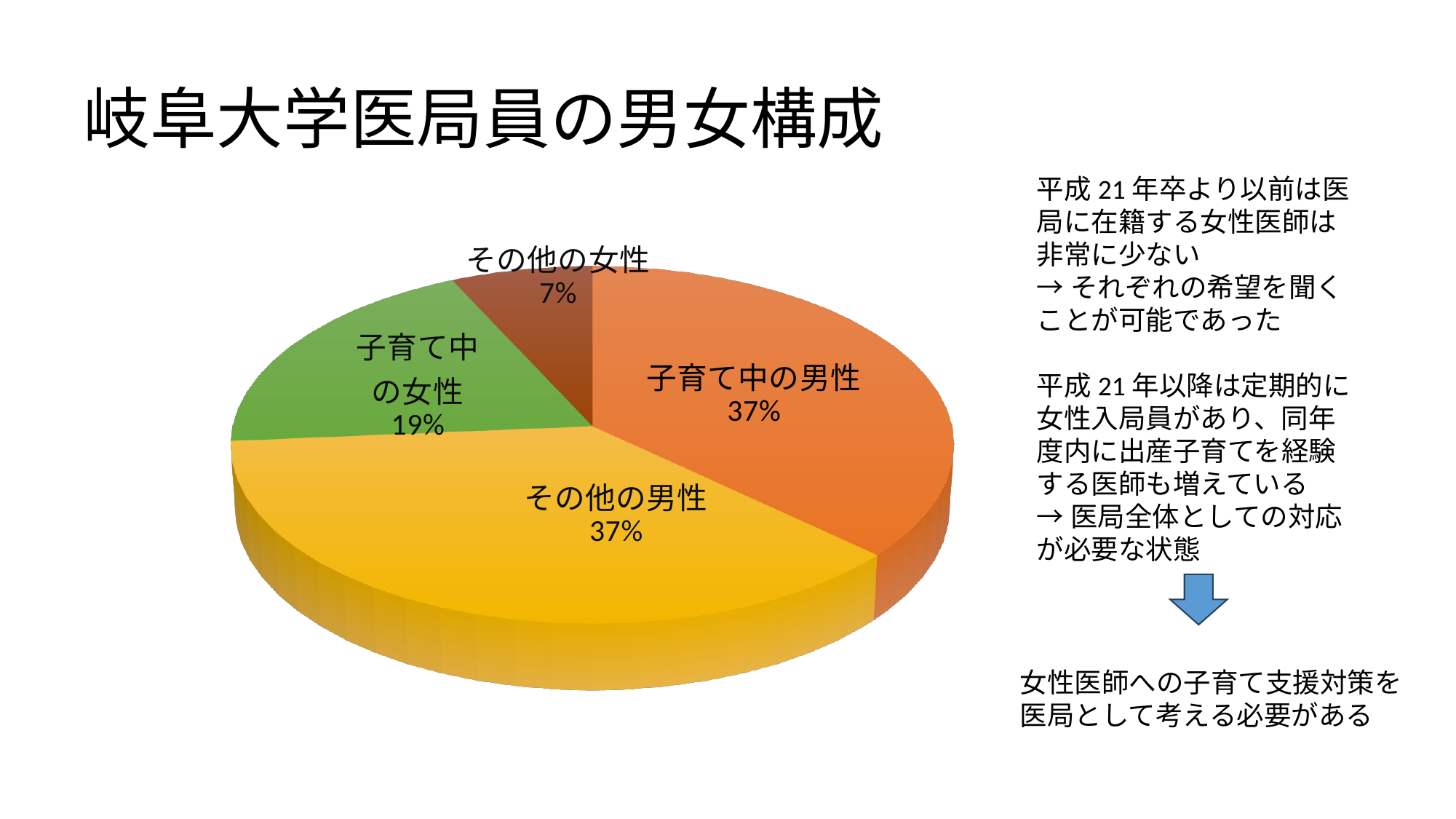
What is the difference between the share for 子育て中の男性 and the share for 子育て中の女性? 18% What kind of chart is shown on the slide? pie chart What share of the pie is labelled その他の女性? 7% What share of the pie is labelled その他の男性? 37% What share of the pie is labelled 子育て中の女性? 19% Which is larger, the share for 子育て中の女性 or the share for その他の女性? 子育て中の女性 What is the difference between the share for 子育て中の女性 and the share for その他の女性? 12% What is the combined share of the two female slices (子育て中の女性 and その他の女性)? 26% Which slice of the pie is the smallest? その他の女性 What is the title of the slide containing the pie chart? 岐阜大学医局員の男女構成 How many slices does the pie chart have? 4 What share of the pie is labelled 子育て中の男性? 37%